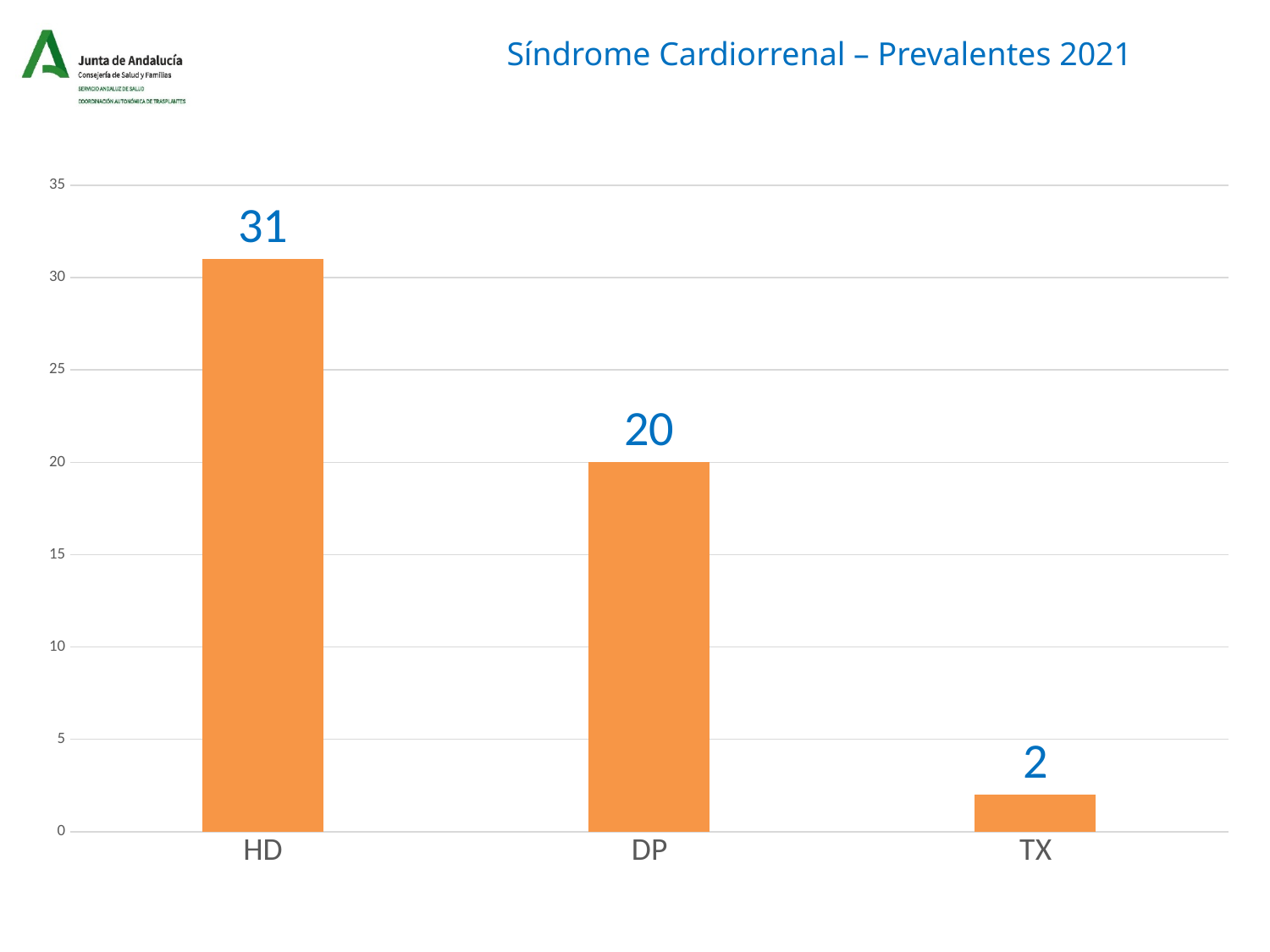
What is the value for DP? 20 What is the difference between the values for DP and TX? 18 What kind of chart is shown on the slide? bar chart What is the value for TX? 2 What is the title of the chart? Síndrome Cardiorrenal – Prevalentes 2021 Which category has the highest value? HD How many categories are shown on the x axis? 3 What is the difference between the values for HD and DP? 11 Which category has the lowest value? TX What is the value for HD? 31 Is the value for HD greater or less than 25? greater Which is larger, the value for DP or the value for TX? DP